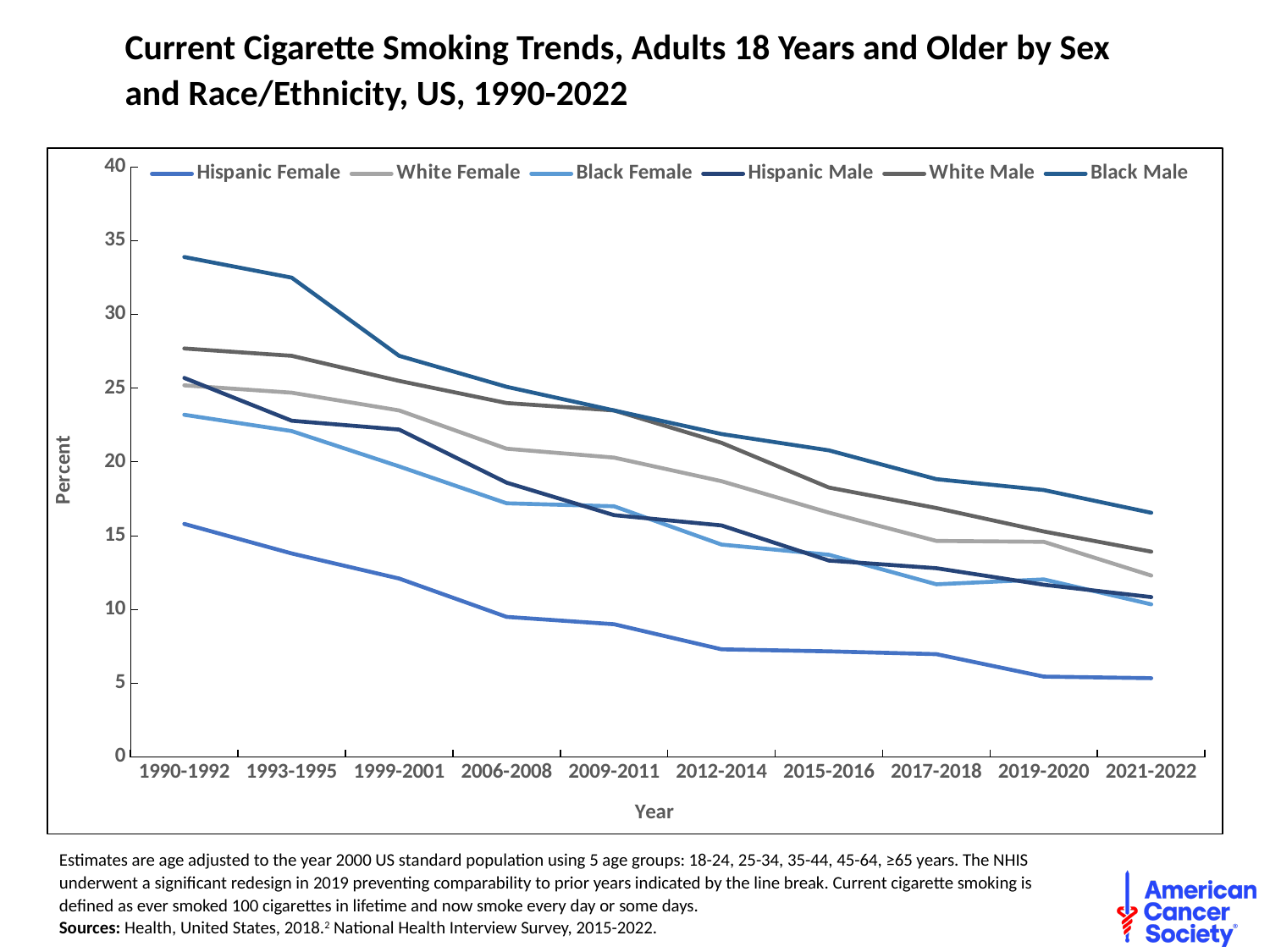
What is the label of the y axis? Percent Is the value for Black Female in 1990-1992 greater or less than 20? greater Is the value for White Female in 2021-2022 greater or less than 15? less In 2006-2008, which is larger: the value for White Male or the value for Black Female? White Male What kind of chart is shown on the slide? line chart Is the value for Hispanic Female in 2021-2022 greater or less than 10? less How many year periods are shown along the x axis? 10 Does the Black Male line rise or fall from 1990-1992 to 2021-2022? fall Which group has the highest smoking percentage in 1990-1992? Black Male How many series does the legend list? 6 Which group has the lowest smoking percentage in 2021-2022? Hispanic Female